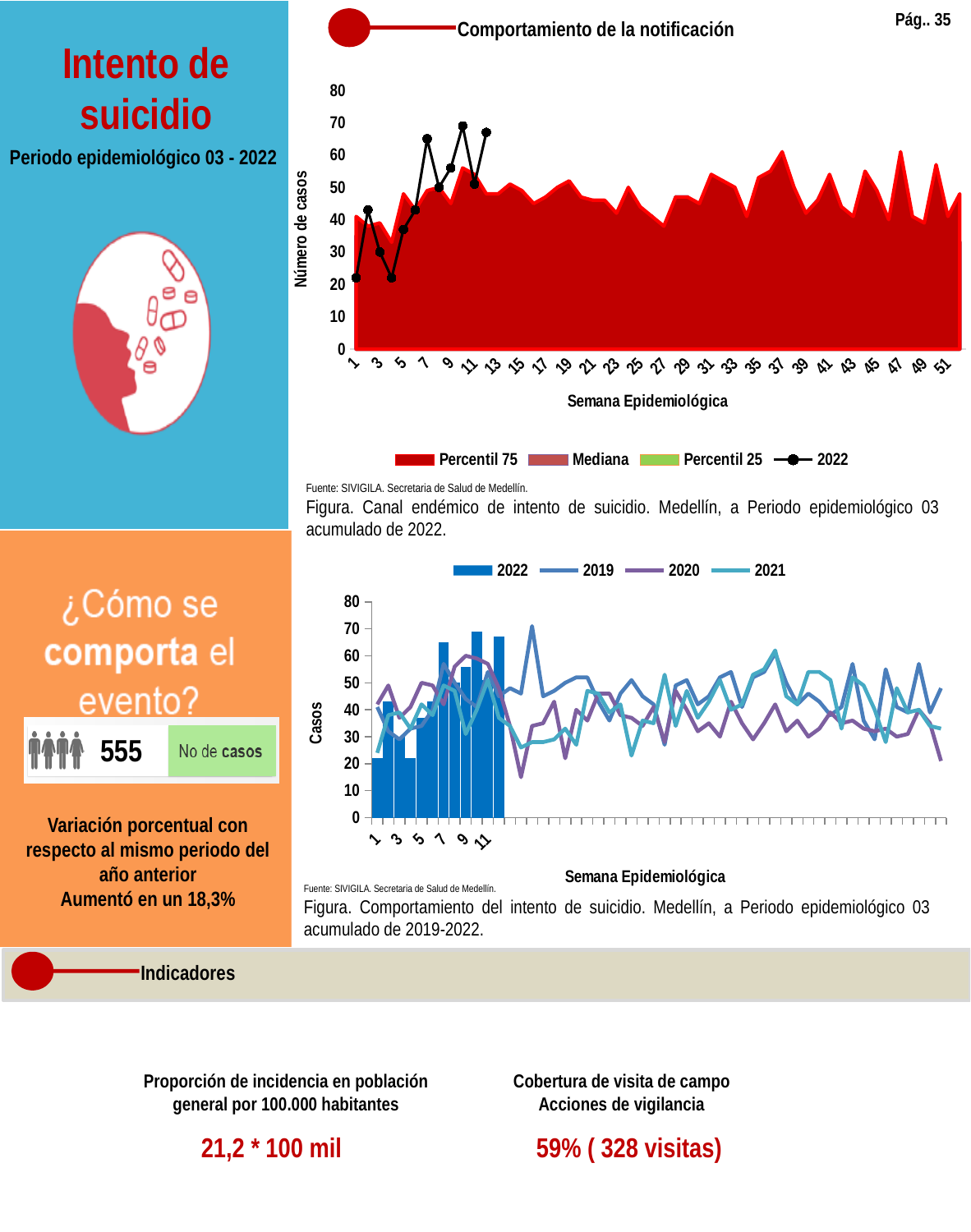
In the bottom chart, is the 2022 bar for week 4 greater or less than 30? less What is the y-axis title of the top chart? Número de casos In the bottom chart, which is larger for 2022: the bar for week 10 or the bar for week 4? week 10 In the bottom chart (Comportamiento del intento de suicidio 2019-2022), how many series does the legend list? 4 In the bottom chart, how many bars are plotted for the 2022 series? 12 In the top chart, is the 2022 value for week 10 greater or less than 60? greater In the bottom chart, is the 2022 bar for week 7 greater or less than 60? greater In the top chart, do the 2022 values overall rise or fall from week 1 to week 12? rise In the top chart, what kind of chart is used for the Percentil 75 series? area chart In the top chart (Canal endémico), how many series does the legend list? 4 In the bottom chart, how is the 2022 series drawn compared with the other years? as bars; the other years are lines